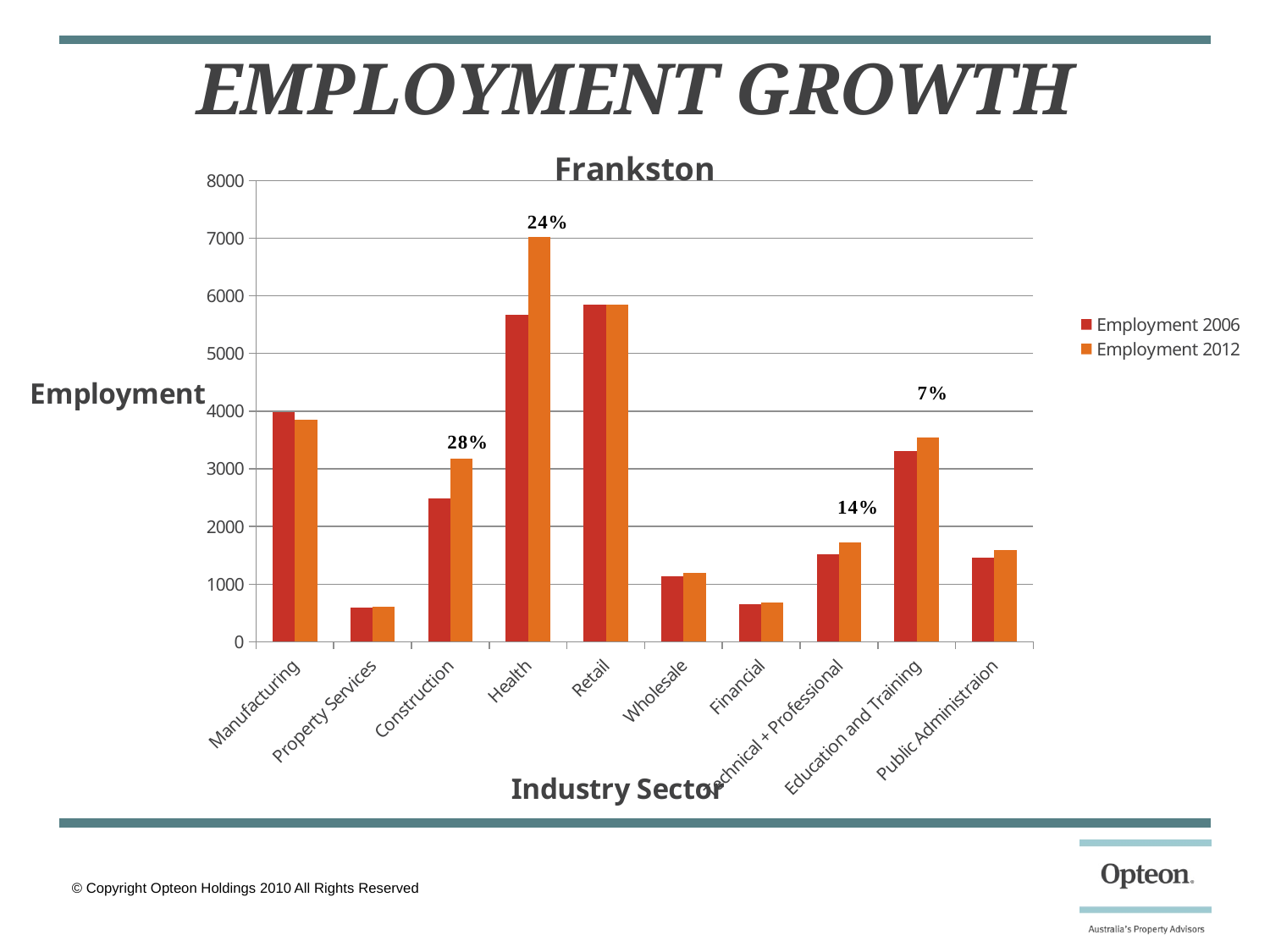
Which is larger: Employment 2012 for Health or Employment 2012 for Retail? Health Is the Employment 2012 value for Property Services greater or less than 1000? less How many series does the legend list? 2 Is the Employment 2006 value for Health greater or less than 5000? greater Which is larger: Employment 2012 for Manufacturing or Employment 2012 for Construction? Manufacturing Is the Employment 2012 value for Education and Training greater or less than 3000? greater What is the title of the chart? Frankston Which industry sector has the highest Employment 2012 value? Health How many industry sectors are shown on the x axis? 10 What kind of chart is shown on the slide? bar chart What growth percentage is printed above the Construction bars? 28%